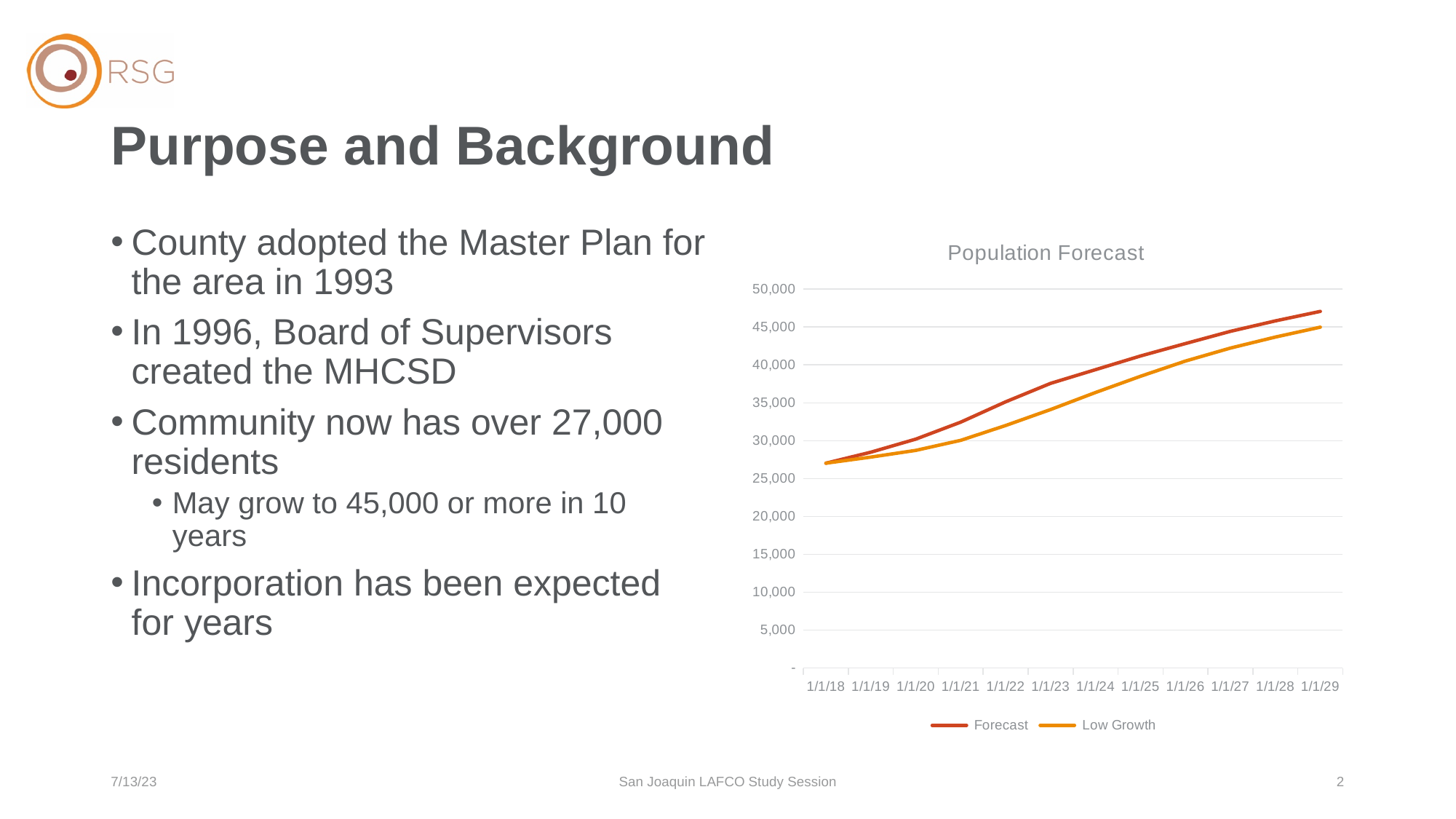
Is the Forecast value at 1/1/18 greater or less than 30,000? less At which date does the Forecast series reach its highest value? 1/1/29 At 1/1/23, which series has the larger value, Forecast or Low Growth? Forecast Is the Forecast value at 1/1/26 greater or less than 40,000? greater What are the names of the two series in the legend? Forecast and Low Growth How many dates are shown along the x axis of the chart? 12 Is the Low Growth value at 1/1/23 greater or less than 35,000? less What kind of chart is shown on the slide? line chart What is the title of the chart? Population Forecast Do the values of the Forecast series rise or fall from 1/1/18 to 1/1/29? rise How many series does the chart's legend list? 2